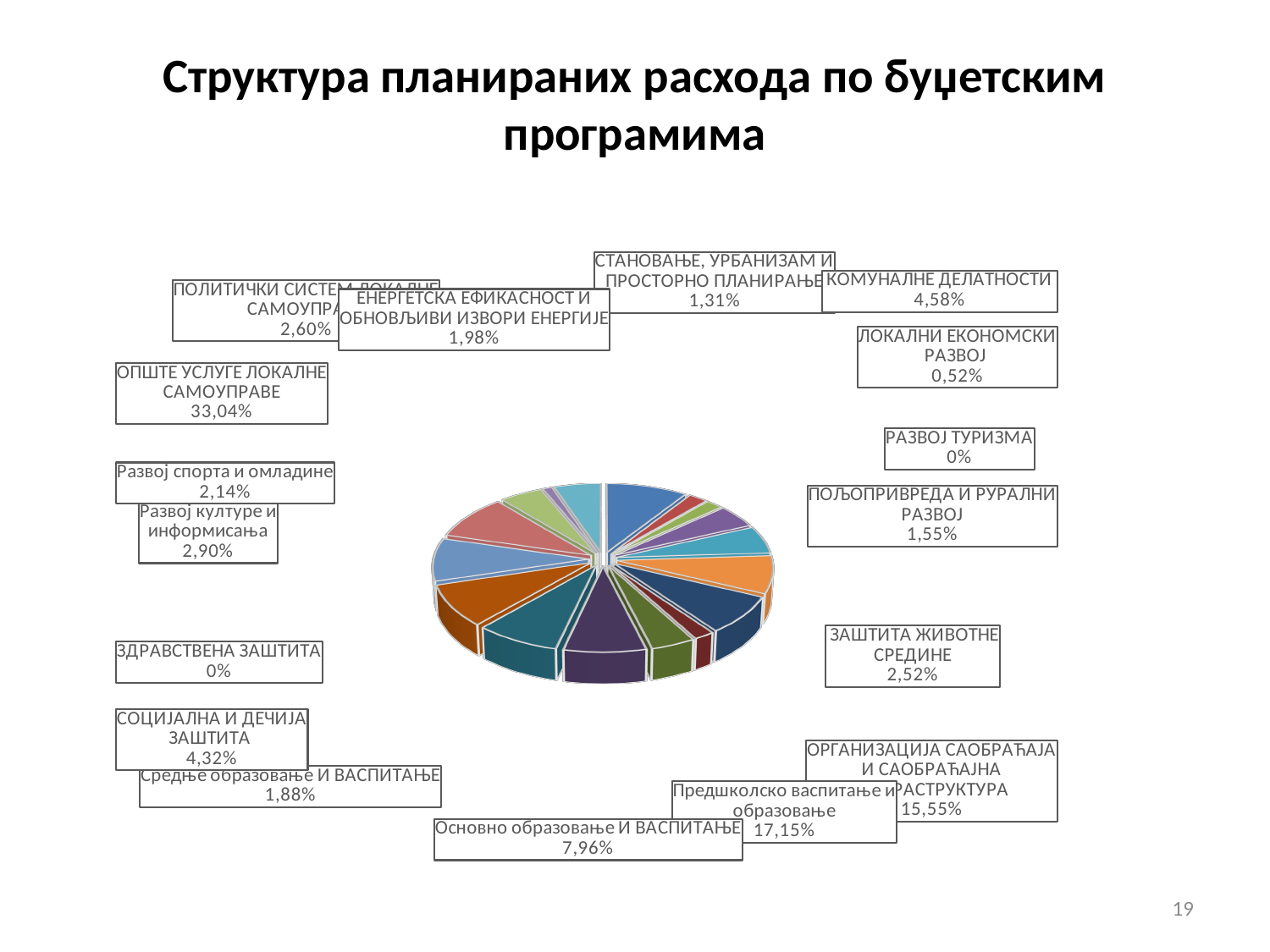
What is the title of the slide containing the chart? Структура планираних расхода по буџетским програмима Which is larger: the share for Предшколско васпитање и образовање or for ОРГАНИЗАЦИЈА САОБРАЋАЈА И САОБРАЋАЈНА ИНФРАСТРУКТУРА? Предшколско васпитање и образовање What type of chart is shown on the slide? Pie chart What share is shown for КОМУНАЛНЕ ДЕЛАТНОСТИ? 4,58% What is the difference between the shares for Предшколско васпитање и образовање and ОРГАНИЗАЦИЈА САОБРАЋАЈА И САОБРАЋАЈНА ИНФРАСТРУКТУРА? 1,60% What share is shown for ОРГАНИЗАЦИЈА САОБРАЋАЈА И САОБРАЋАЈНА ИНФРАСТРУКТУРА? 15,55% How many categories are labelled on the pie chart? 17 Which category has the largest share of the pie? ОПШТЕ УСЛУГЕ ЛОКАЛНЕ САМОУПРАВЕ What share is shown for ОПШТЕ УСЛУГЕ ЛОКАЛНЕ САМОУПРАВЕ? 33,04% What share is shown for ЛОКАЛНИ ЕКОНОМСКИ РАЗВОЈ? 0,52% What is the difference between the shares for ОПШТЕ УСЛУГЕ ЛОКАЛНЕ САМОУПРАВЕ and Предшколско васпитање и образовање? 15,89% What share is shown for Предшколско васпитање и образовање? 17,15%